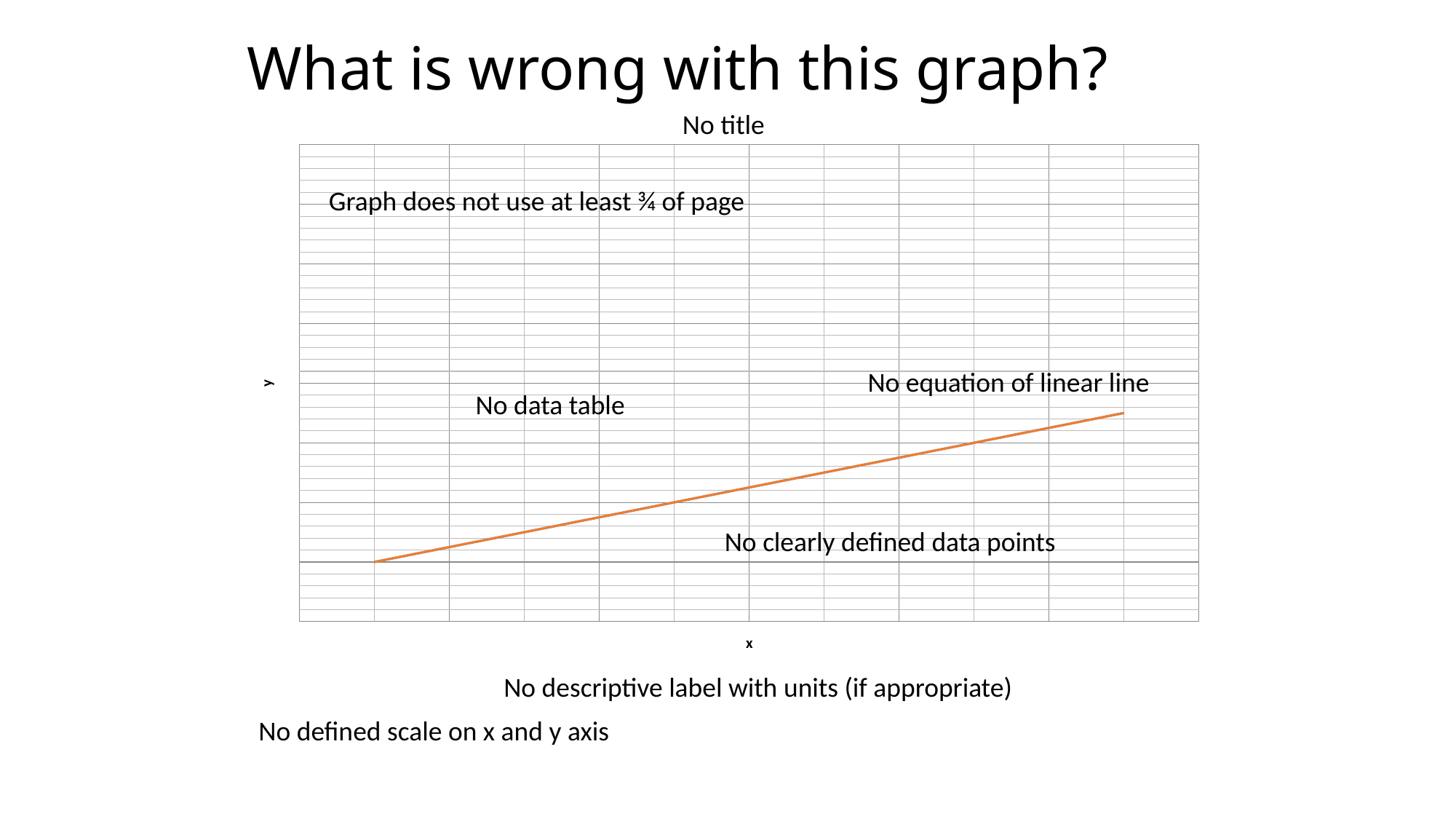
Does the plotted line rise or fall from left to right along the x axis? rise What colour is the plotted line on the chart? orange What is the label on the horizontal axis of the chart? x What kind of chart is shown on the slide? line chart